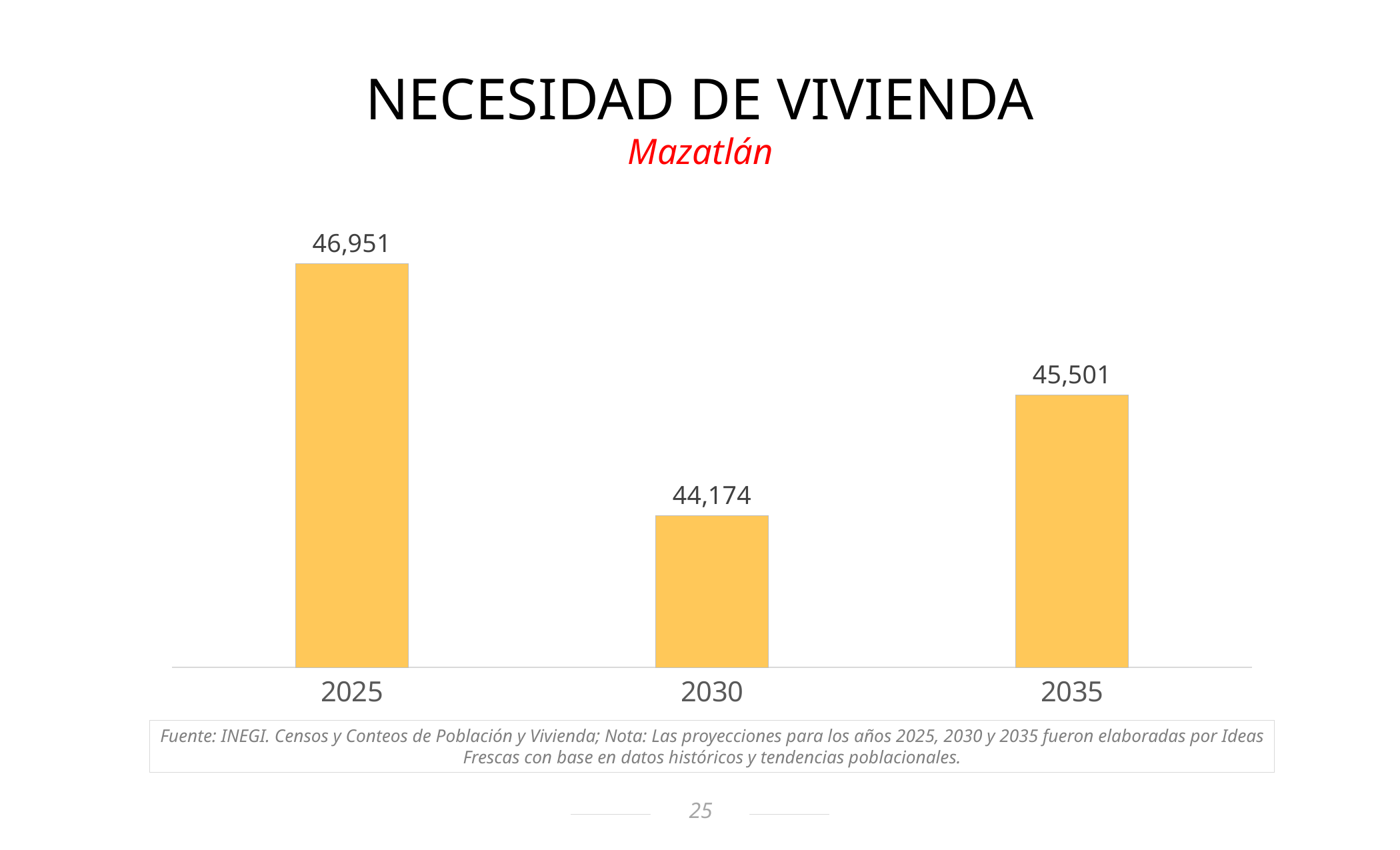
Which city is named in the red subtitle of the chart? Mazatlán Which year has the lowest housing need value? 2030 Which year has the highest housing need value? 2025 Which is larger, the value for 2025 or the value for 2035? 2025 What is the housing need value shown for 2035? 45,501 What is the difference between the values for 2025 and 2030? 2,777 What is the difference between the values for 2035 and 2030? 1,327 What kind of chart is shown on the slide? Bar chart Does the value fall or rise from 2025 to 2030? Fall How many years are shown on the chart? 3 What is the housing need value shown for 2025? 46,951 What is the housing need value shown for 2030? 44,174